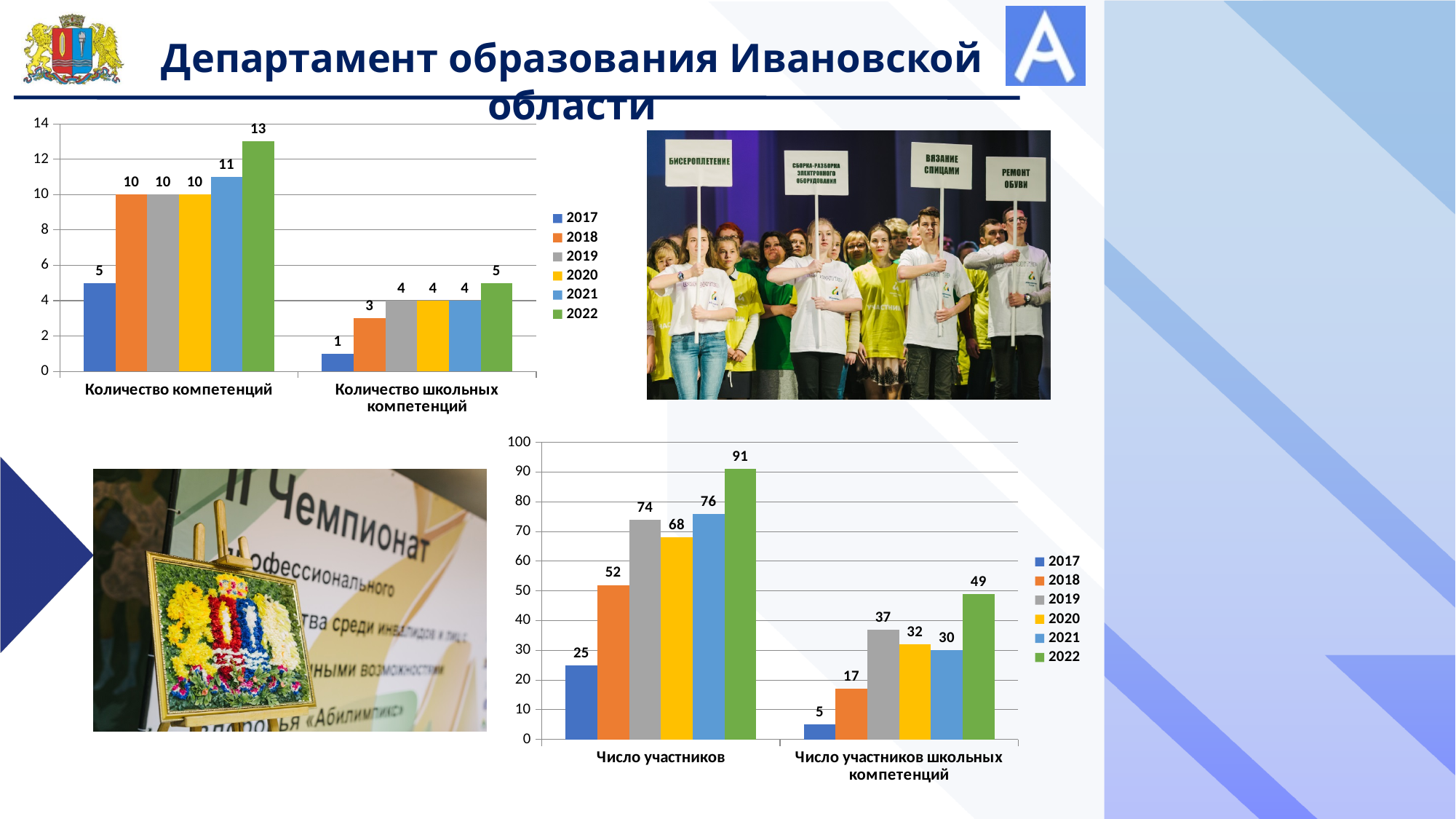
How many series does the legend of the top-left chart list? 6 In the top-left chart, what is the value for 2017 in the category "Количество школьных компетенций"? 1 In the bottom-right chart, what is the value for 2022 in the category "Число участников школьных компетенций"? 49 In the bottom-right chart, which year has the lowest value for "Число участников"? 2017 What kind of chart is the top-left chart? Bar chart In the top-left chart, what is the difference between the 2022 and 2017 values for "Количество компетенций"? 8 In the top-left chart, what is the value for 2022 in the category "Количество компетенций"? 13 In the top-left chart, which year has the highest value for "Количество компетенций"? 2022 In the bottom-right chart, what is the value for 2019 in the category "Число участников"? 74 How many categories are shown on the x axis of the bottom-right chart? 2 In the bottom-right chart, what is the difference between the 2022 and 2021 values for "Число участников"? 15 In the bottom-right chart, which is larger for "Число участников": the 2020 value or the 2021 value? 2021